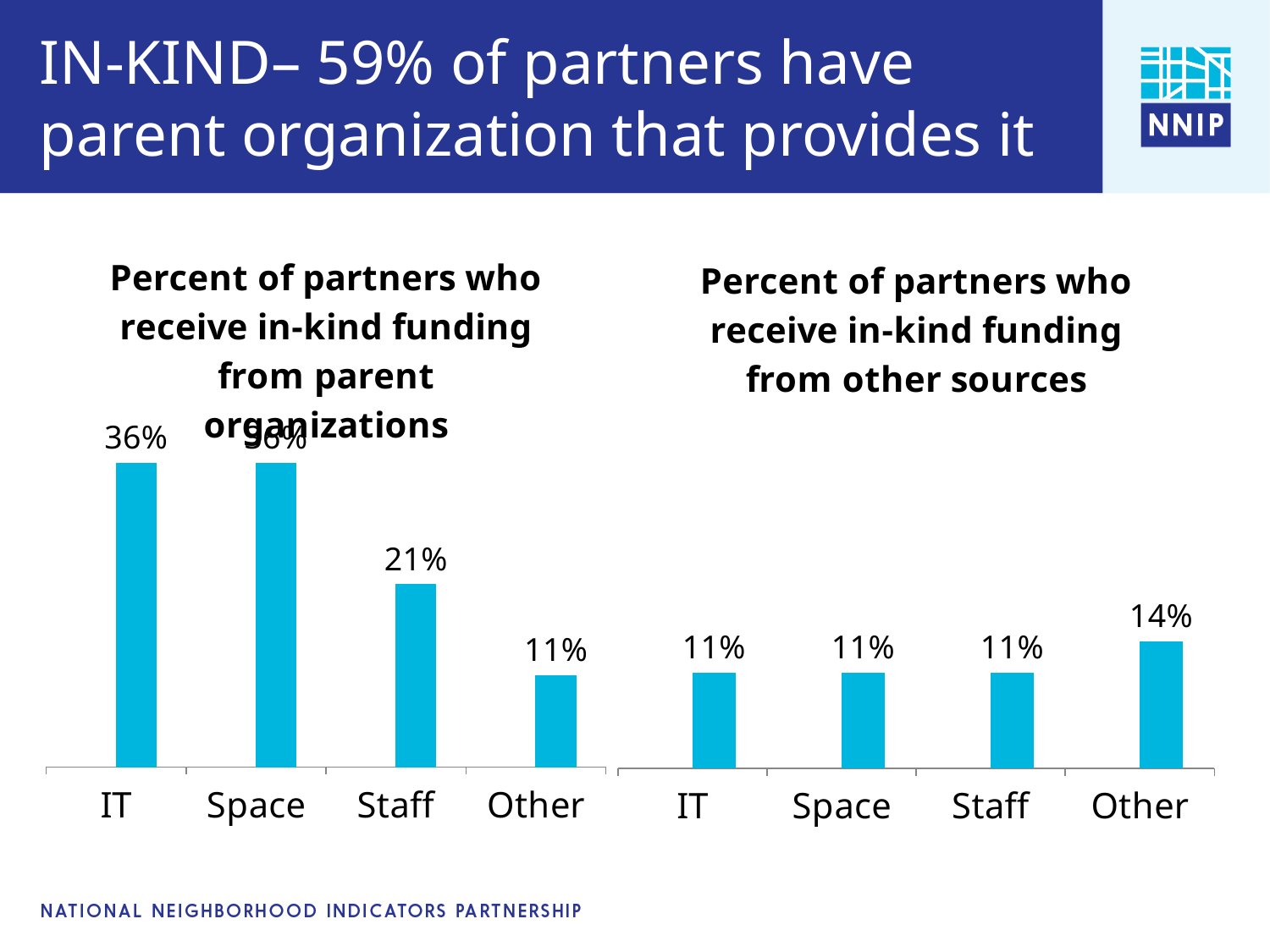
In the chart titled 'Percent of partners who receive in-kind funding from parent organizations', what is the value for Staff? 21% In the chart titled 'Percent of partners who receive in-kind funding from other sources', what is the value for Other? 14% In the chart titled 'Percent of partners who receive in-kind funding from parent organizations', which category has the lowest value? Other In the chart titled 'Percent of partners who receive in-kind funding from parent organizations', what is the value for IT? 36% In the chart titled 'Percent of partners who receive in-kind funding from parent organizations', what is the difference between the values for IT and Staff? 15% In the chart titled 'Percent of partners who receive in-kind funding from other sources', which category has the highest value? Other How many categories are shown in the chart titled 'Percent of partners who receive in-kind funding from other sources'? 4 In the chart titled 'Percent of partners who receive in-kind funding from other sources', what is the difference between the values for Other and IT? 3% In the chart titled 'Percent of partners who receive in-kind funding from other sources', what is the value for Staff? 11% What kind of chart is the chart on the left of the slide? Bar chart In the chart titled 'Percent of partners who receive in-kind funding from parent organizations', which is larger, the value for Staff or the value for Other? Staff In the chart titled 'Percent of partners who receive in-kind funding from parent organizations', what is the value for Other? 11%